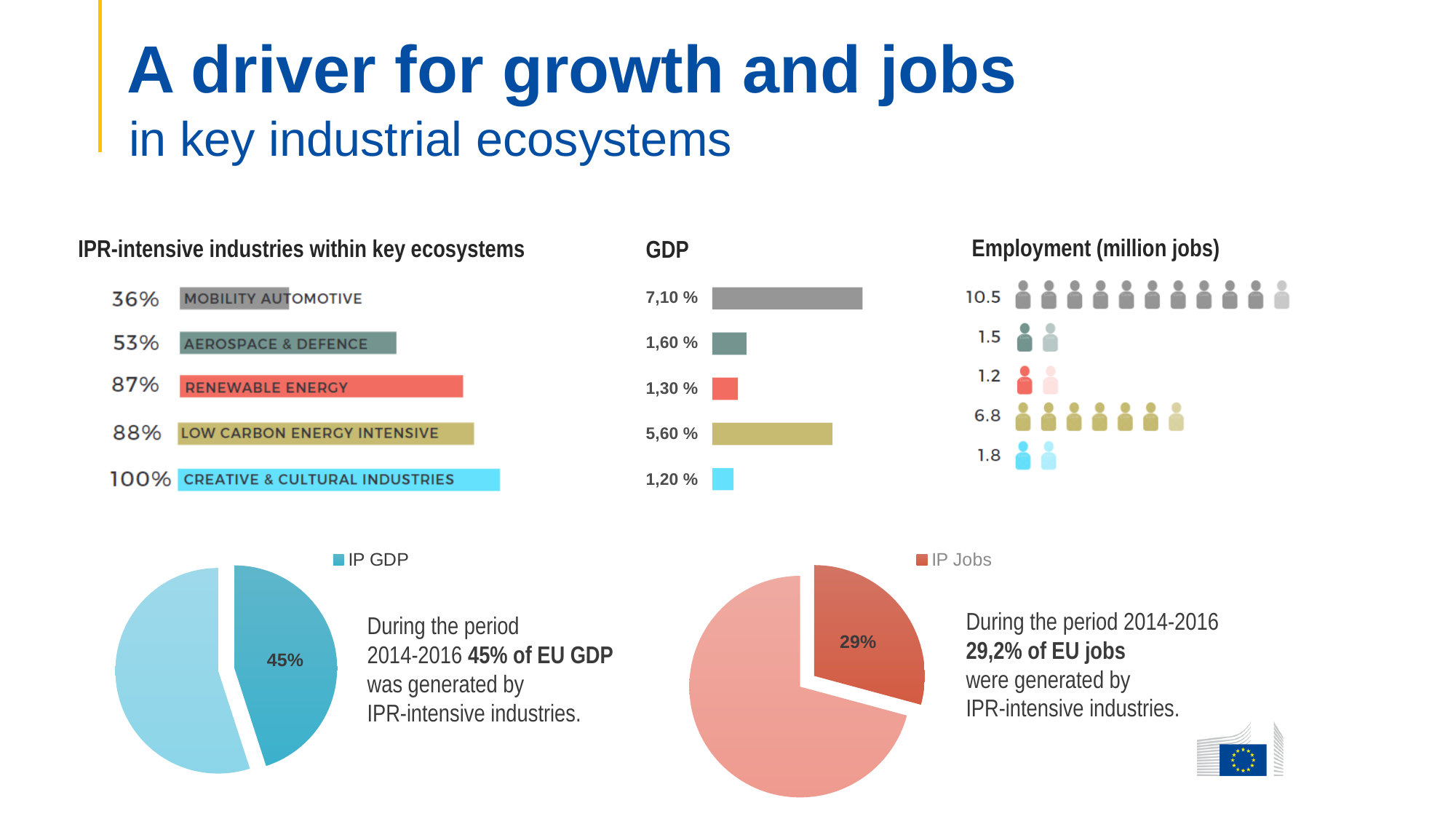
In the 'IPR-intensive industries within key ecosystems' chart, what is the value for Renewable Energy? 87% In the 'IP GDP' pie chart, what share is shown for the highlighted slice? 45% In the 'GDP' chart, what is the value of the smallest bar? 1,20 % In the 'GDP' chart, what is the value of the largest bar? 7,10 % What kind of chart is the 'GDP' chart? Bar chart In the 'Employment (million jobs)' chart, what is the largest value shown? 10.5 In the 'IP Jobs' pie chart, what share is shown for the highlighted slice? 29% In the 'IPR-intensive industries within key ecosystems' chart, which category has the lowest value? Mobility Automotive In the 'IPR-intensive industries within key ecosystems' chart, which category has the highest value? Creative & Cultural Industries In the 'IPR-intensive industries within key ecosystems' chart, what is the difference between Aerospace & Defence and Mobility Automotive? 17% In the 'GDP' chart, which is larger: the bar labelled 5,60 % or the bar labelled 1,60 %? 5,60 % How many categories are shown in the 'IPR-intensive industries within key ecosystems' chart? 5